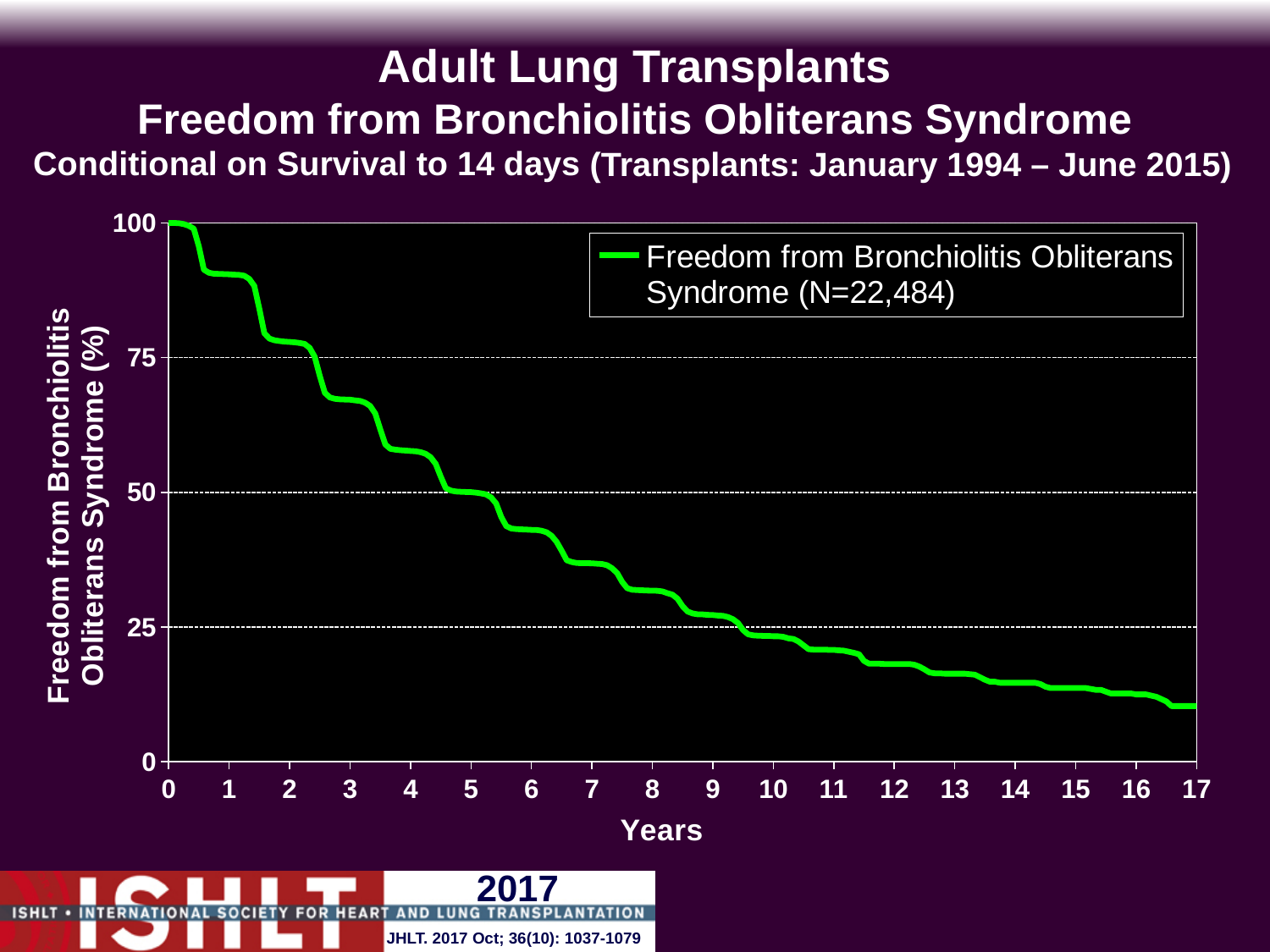
Does the freedom from Bronchiolitis Obliterans Syndrome rise or fall as the years increase? fall Is the value for freedom from BOS at year 4 greater or less than 50? greater Is the value for freedom from BOS at year 1 greater or less than 75? greater How many series does the legend list? 1 Is the value for freedom from BOS at year 8 greater or less than 25? greater What kind of chart is shown on the slide? line chart What is the label of the x axis? Years What is the sample size (N) given in the legend? 22,484 What is the value of the curve at year 0? 100